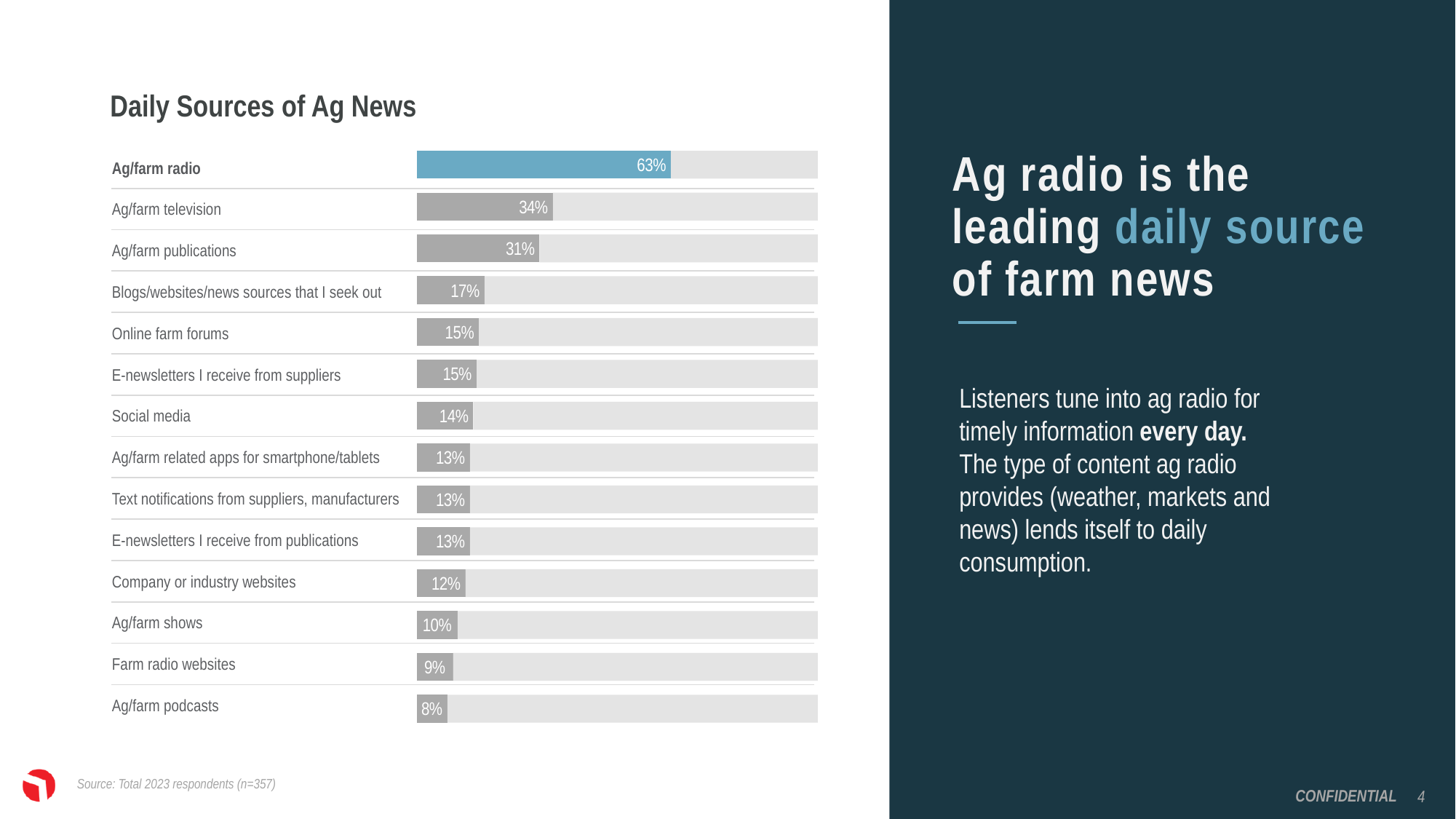
What is the value shown for ag/farm television? 34% What is the difference in percentage points between ag/farm radio and ag/farm television? 29 How many daily sources of ag news are listed in the chart? 14 What percentage is shown for social media? 14% What is the value for ag/farm podcasts? 8% What is the title of the chart? Daily Sources of Ag News Which daily source of ag news has the highest percentage? Ag/farm radio What is the difference in percentage points between ag/farm publications and blogs/websites/news sources that I seek out? 14 What type of chart is used to show the daily sources of ag news? Bar chart Which daily source of ag news has the lowest percentage? Ag/farm podcasts Which has a higher value, ag/farm shows or farm radio websites? Ag/farm shows What percentage of respondents use ag/farm radio as a daily source of ag news? 63%